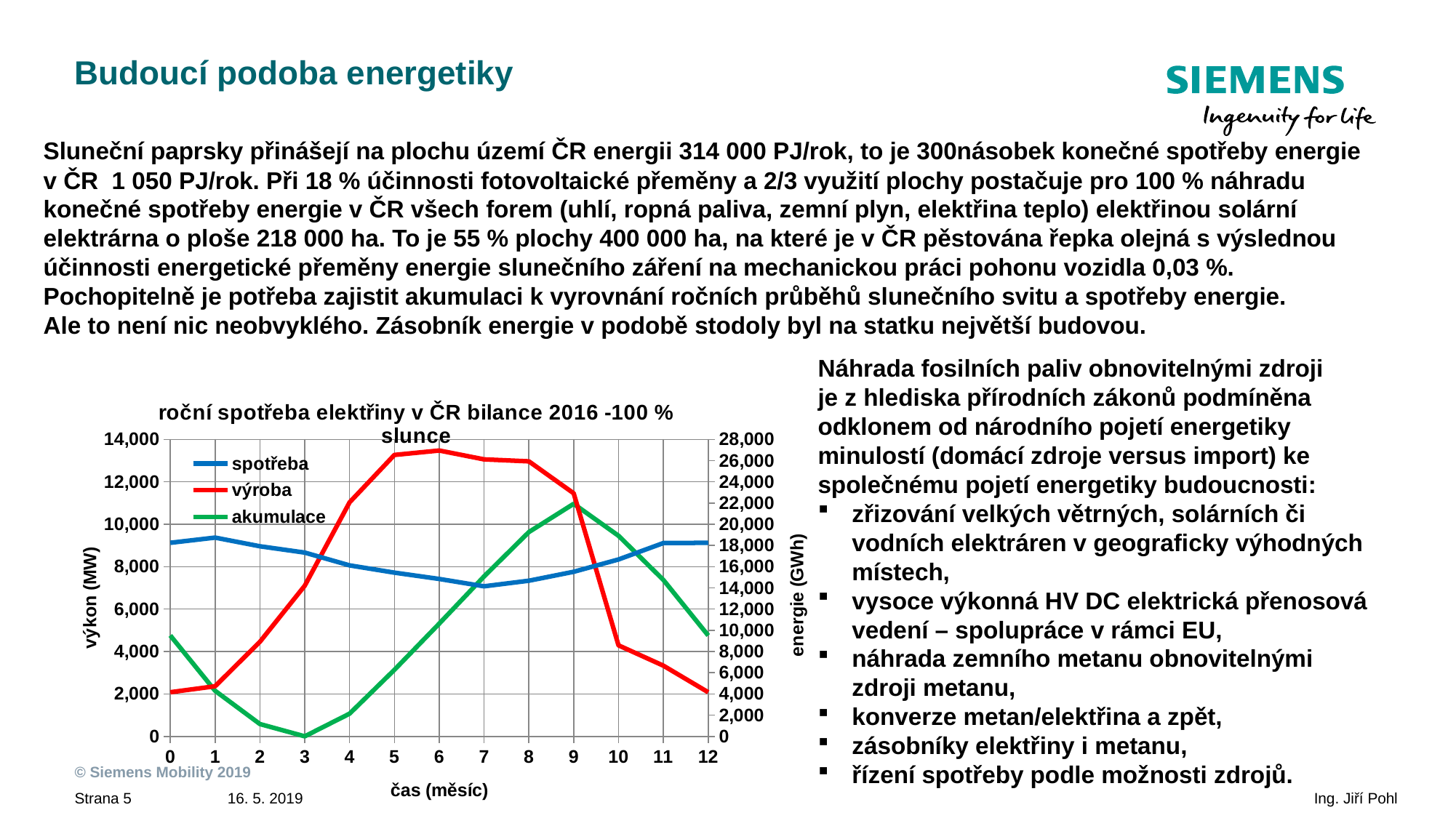
Is the value of výroba at month 0 greater or less than 4,000? less At which month does akumulace reach its lowest value? 3 Does výroba rise or fall between month 6 and month 12? fall What are the series names listed in the chart legend? spotřeba, výroba, akumulace What is the title of the right-hand vertical axis of the chart? energie (GWh) Is the value of výroba at month 6 greater or less than 12,000? greater At month 6, which series is higher, výroba or spotřeba? výroba How many series does the chart legend list? 3 Is the value of akumulace at month 9 greater or less than 20,000 on the right axis? greater At month 0, which series is higher, spotřeba or výroba? spotřeba What kind of chart is shown on the slide? line chart